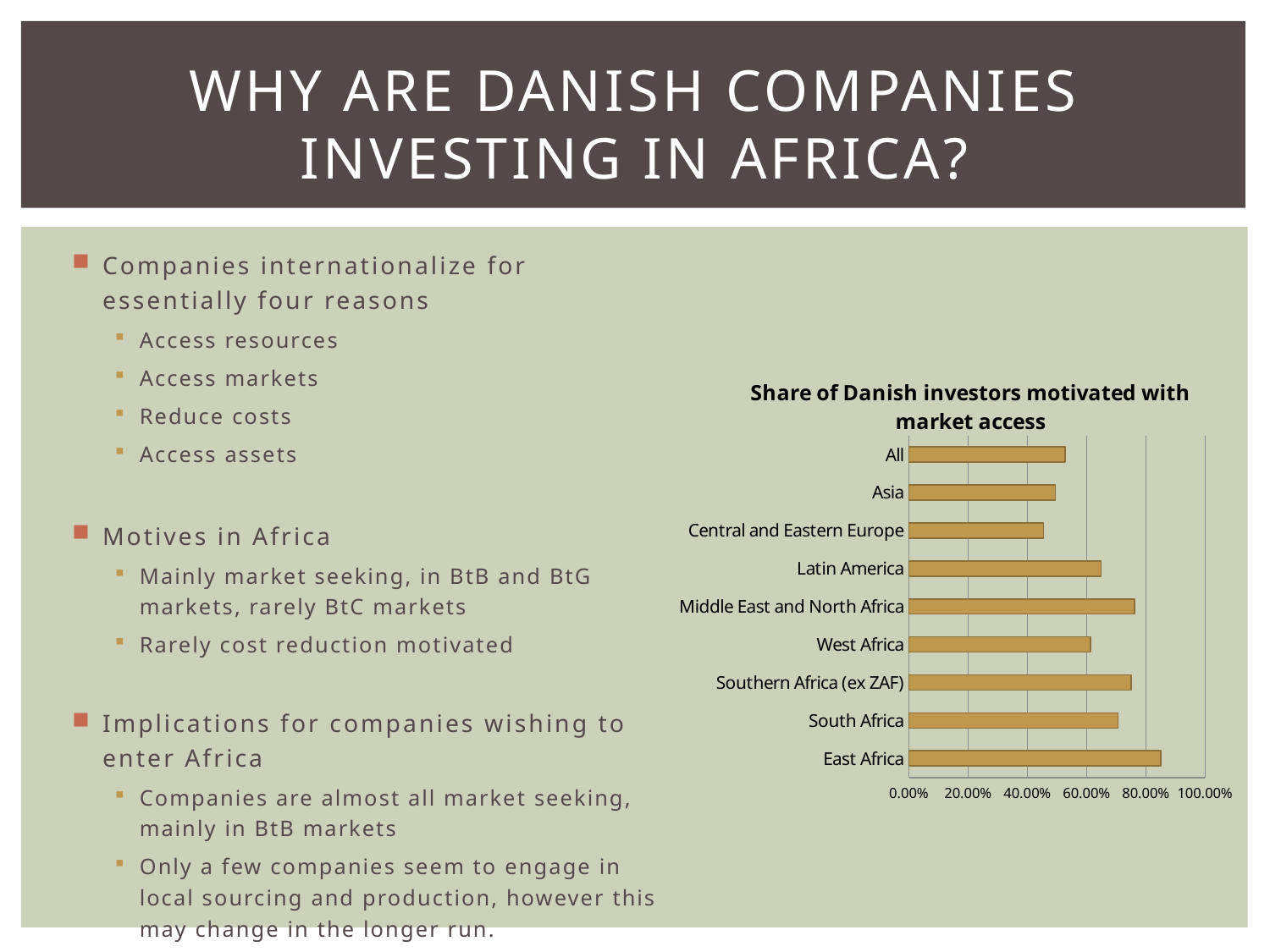
Is the value for East Africa greater or less than 80.00%? greater Is the value for Asia greater or less than 60.00%? less Which has a larger share: Latin America or Central and Eastern Europe? Latin America Is the value for West Africa greater or less than 80.00%? less What type of chart is shown on the slide? Bar chart Which has a larger share: East Africa or Asia? East Africa Which has a larger share: Middle East and North Africa or West Africa? Middle East and North Africa Which region has the highest share of Danish investors motivated with market access? East Africa How many categories (regions) are plotted in the chart? 9 What is the title of the chart? Share of Danish investors motivated with market access